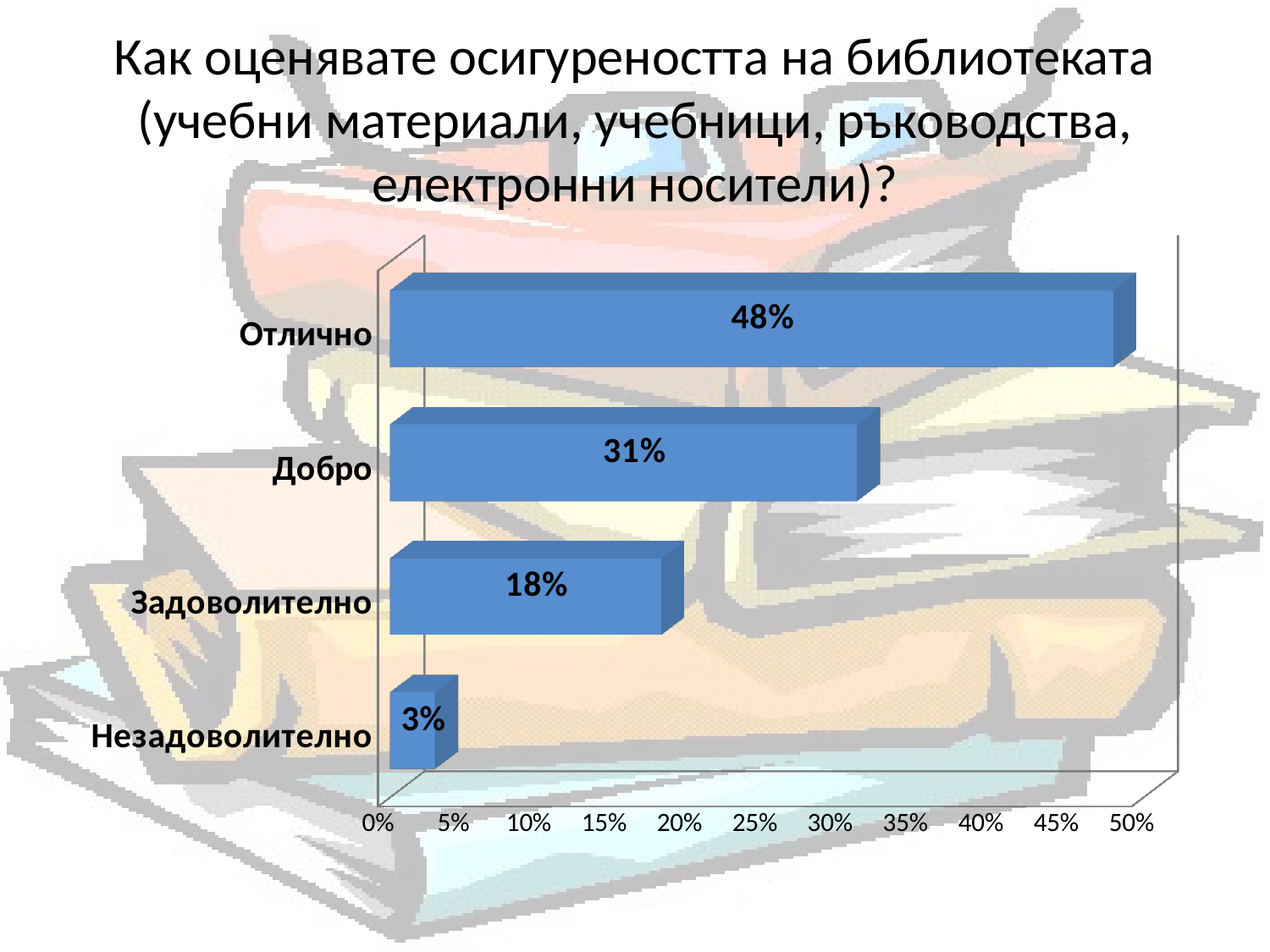
What kind of chart is shown on the slide? Bar chart What is the difference between the values for Задоволително and Незадоволително? 15% What is the difference between the values for Отлично and Добро? 17% What is the value for Задоволително? 18% Which is larger, the value for Добро or the value for Задоволително? Добро What is the value for Отлично? 48% How many categories are shown in the chart? 4 What is the maximum value shown on the horizontal axis? 50% Which category has the highest value? Отлично Which category has the lowest value? Незадоволително What is the value for Незадоволително? 3% What is the value for Добро? 31%